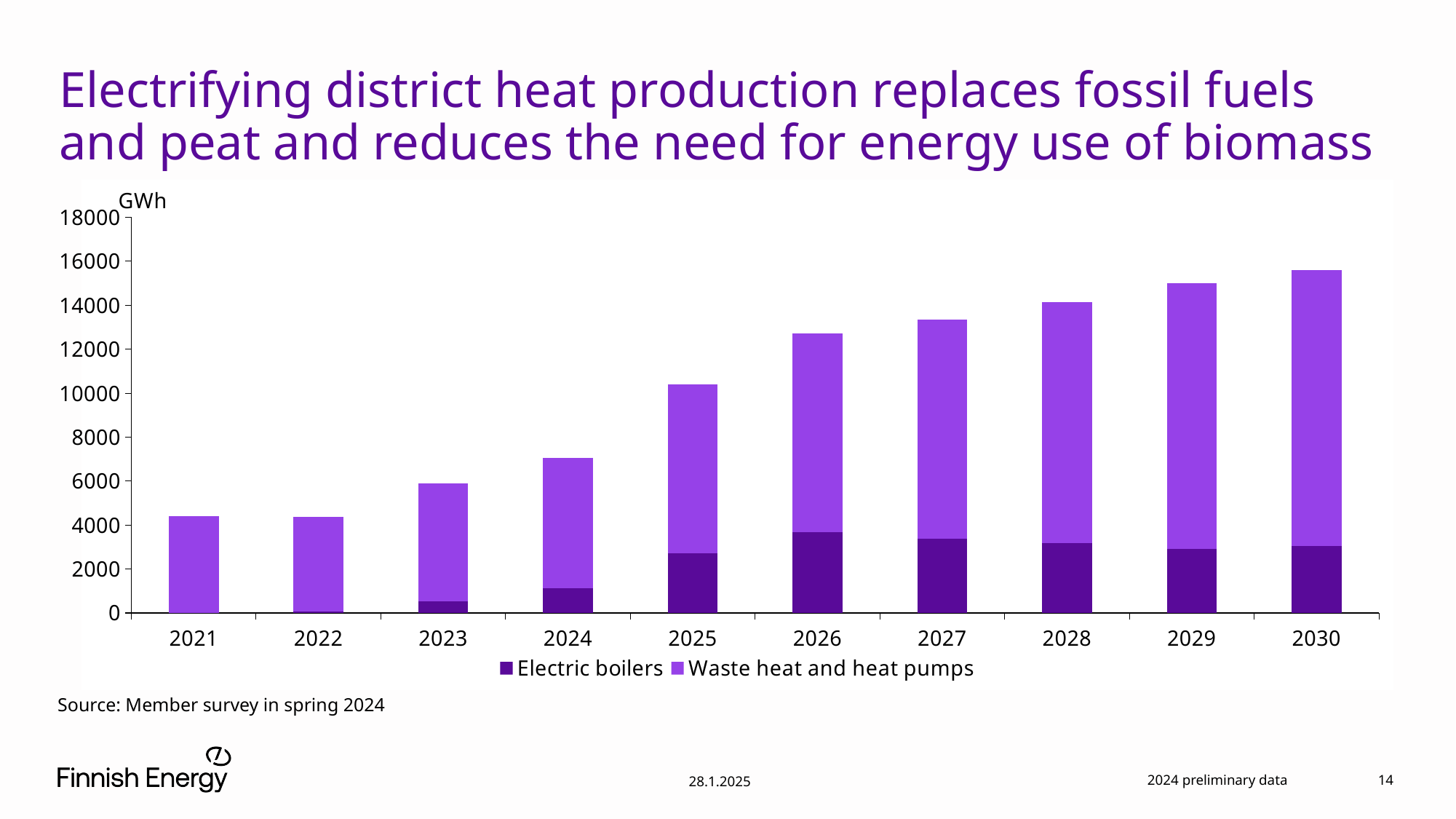
Is the total value for 2026 greater or less than 12000? greater Is the total value for 2030 greater or less than 14000? greater Which series is shown in the darker purple colour in the chart? Electric boilers Is the total value for 2024 greater or less than 8000? less What unit is shown at the top of the y axis of the chart? GWh Do the total bar heights generally rise or fall from 2021 to 2030? rise How many years are shown on the x axis of the chart? 10 Which year has the highest total bar in the chart? 2030 Which year has the larger total bar, 2021 or 2030? 2030 What kind of chart is shown on the slide? stacked bar chart How many series does the chart legend list? 2